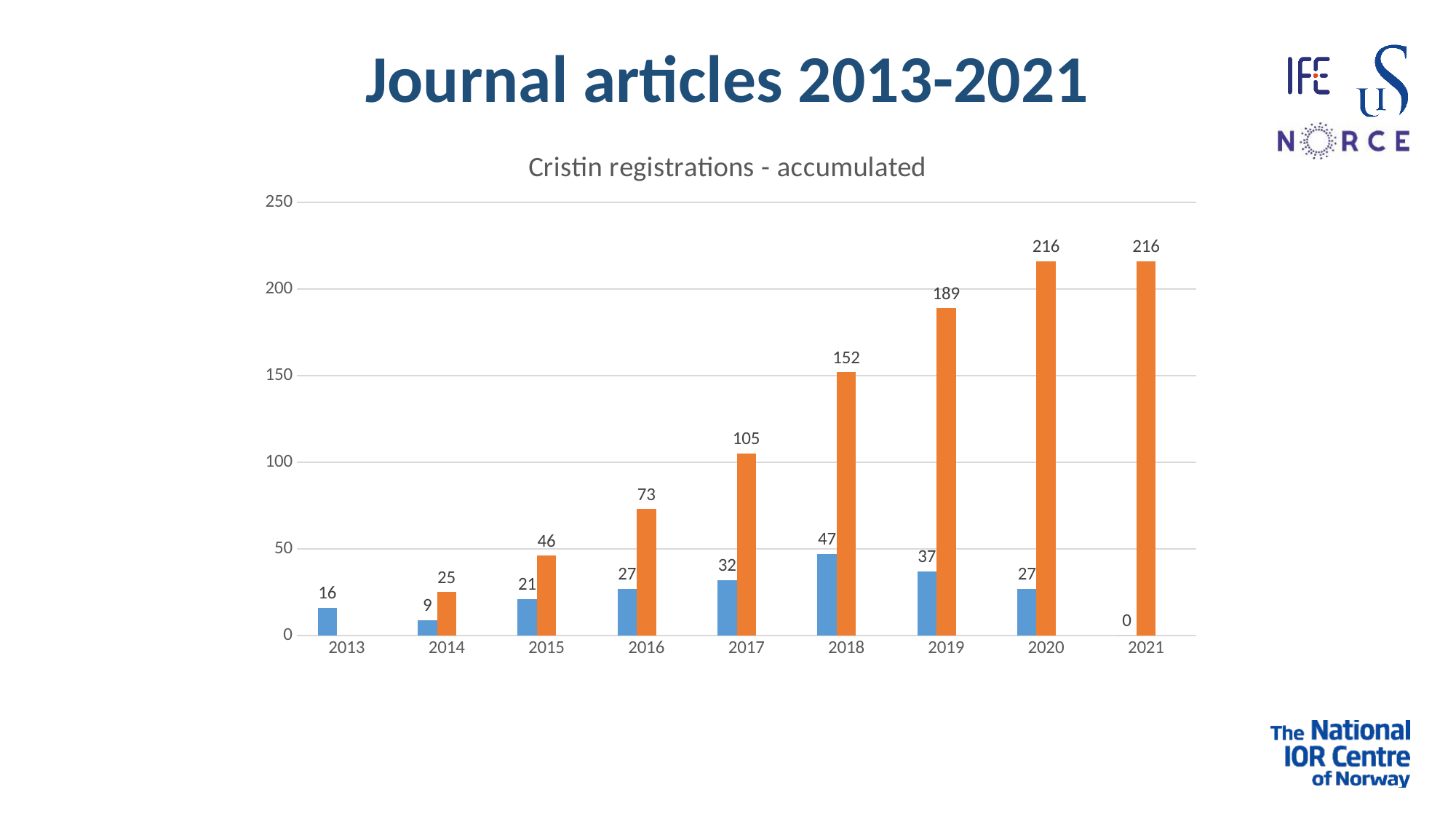
Which is larger, the blue bar for 2019 or the blue bar for 2020? 2019 Which year has the highest blue bar? 2018 Do the orange bars rise or fall from 2014 to 2020? Rise What kind of chart is shown on the slide? Bar chart What is the value of the orange bar for 2018? 152 What is the value of the blue bar for 2017? 32 What is the title of the chart? Cristin registrations - accumulated What is the value of the orange bar for 2021? 216 What is the difference between the orange bar values for 2019 and 2018? 37 How many years are shown on the x axis? 9 Which year has the lowest blue bar? 2021 Is the orange bar for 2017 greater or less than 100? greater